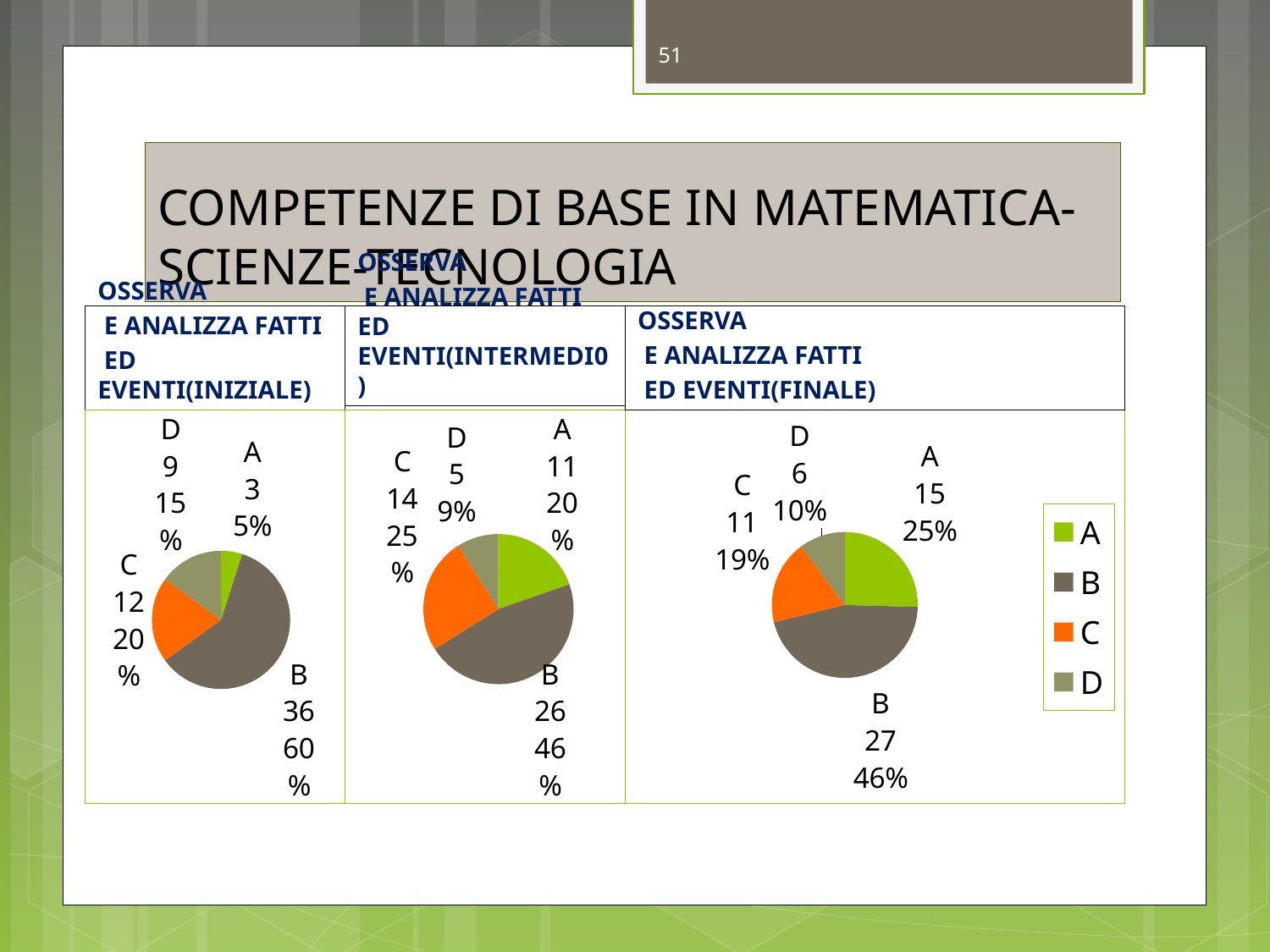
How many categories does the legend on the right list? 4 In the right pie chart (FINALE), what count is shown for category B? 27 What type of chart is used on this slide? Pie chart In the right pie chart (FINALE), which is larger, the share for C or the share for D? C In the left pie chart (INIZIALE), what count is shown for category C? 12 In the middle pie chart (INTERMEDIO), what count is shown for category D? 5 In the middle pie chart (INTERMEDIO), what percentage is shown for category C? 25% In the middle pie chart (INTERMEDIO), which category has the largest share? B In the left pie chart (INIZIALE), which category has the smallest share? A In the right pie chart (FINALE), what percentage is shown for category A? 25% In the left pie chart (INIZIALE), what percentage is shown for category B? 60% In the right pie chart (FINALE), what is the difference between the counts for B and A? 12